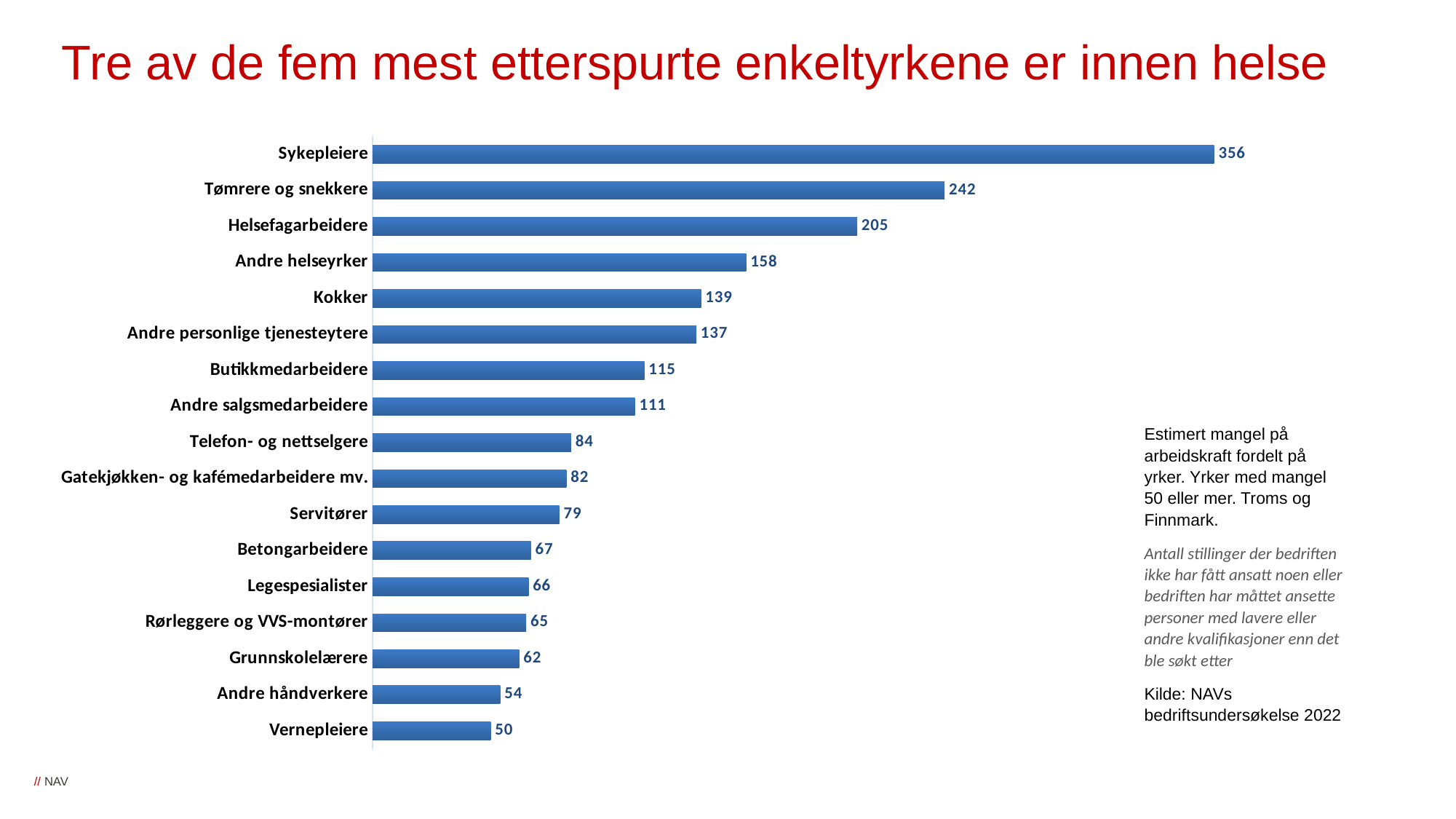
What is the source cited for the chart data? NAVs bedriftsundersøkelse 2022 What kind of chart is shown on the slide? Bar chart What is the value for Kokker? 139 What is the value for Grunnskolelærere? 62 Which is larger, the value for Servitører or the value for Telefon- og nettselgere? Telefon- og nettselgere What is the value for Sykepleiere? 356 How many categories are shown in the chart? 17 What is the difference between the values for Helsefagarbeidere and Andre helseyrker? 47 What is the difference between the values for Sykepleiere and Tømrere og snekkere? 114 Which category has the lowest value? Vernepleiere Which category has the highest value? Sykepleiere Which is larger, the value for Butikkmedarbeidere or the value for Andre salgsmedarbeidere? Butikkmedarbeidere